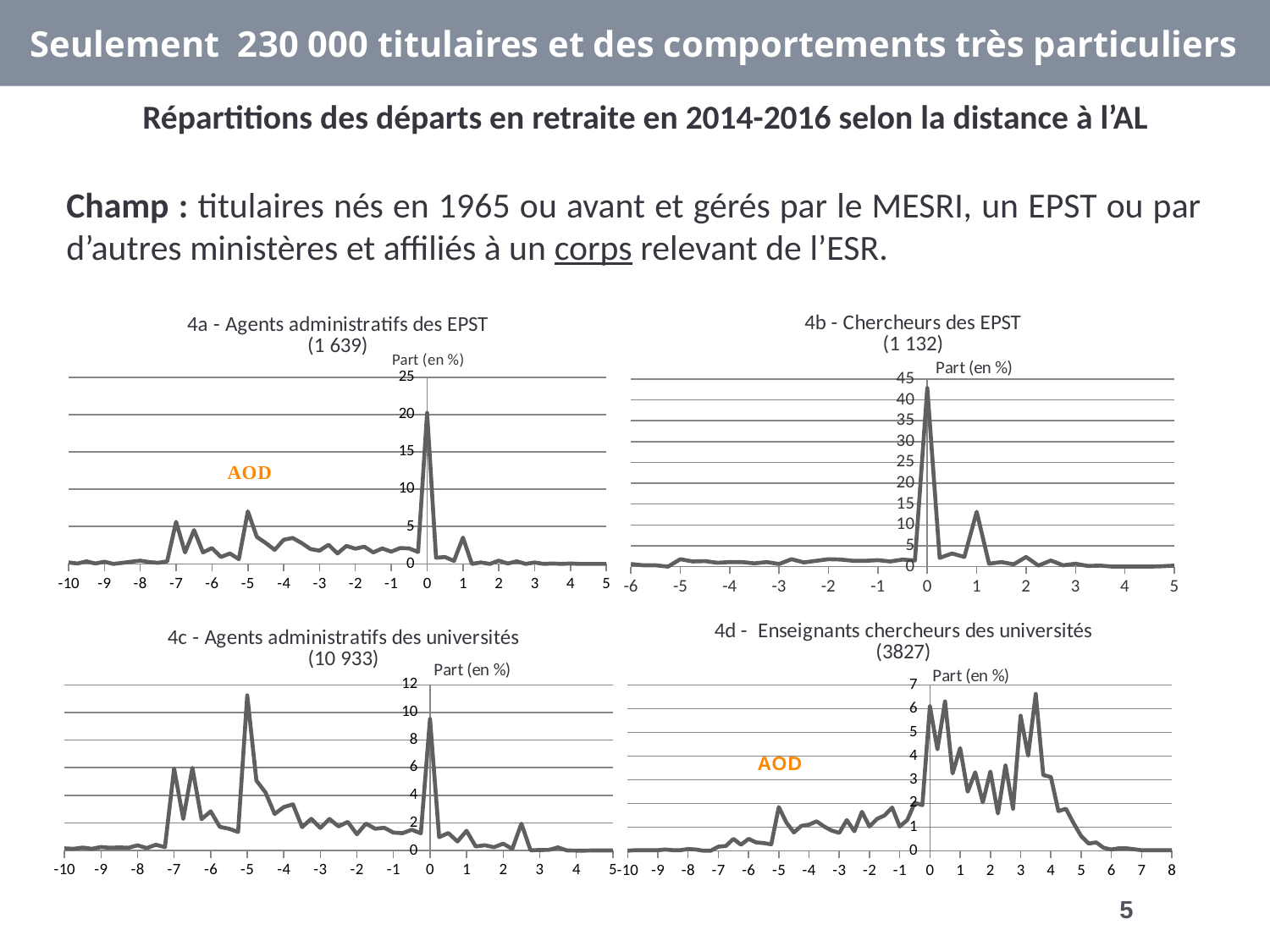
In chart '4b - Chercheurs des EPST', is the value at x = 1 greater or less than 10? greater What kind of chart is '4a - Agents administratifs des EPST'? line chart In chart '4a - Agents administratifs des EPST', is the value at x = 0 greater or less than 15? greater In chart '4c - Agents administratifs des universités', which is larger: the value at x = -5 or the value at x = 0? x = -5 What is the y-axis label of chart '4d - Enseignants chercheurs des universités'? Part (en %) In chart '4c - Agents administratifs des universités', is the value at x = -5 greater or less than 10? greater In chart '4c - Agents administratifs des universités', at which x-axis value does the line reach its highest point? -5 What number appears in parentheses under the title of chart '4c - Agents administratifs des universités'? 10 933 In chart '4b - Chercheurs des EPST', at which x-axis value does the line reach its highest point? 0 How many charts are shown on the slide? 4